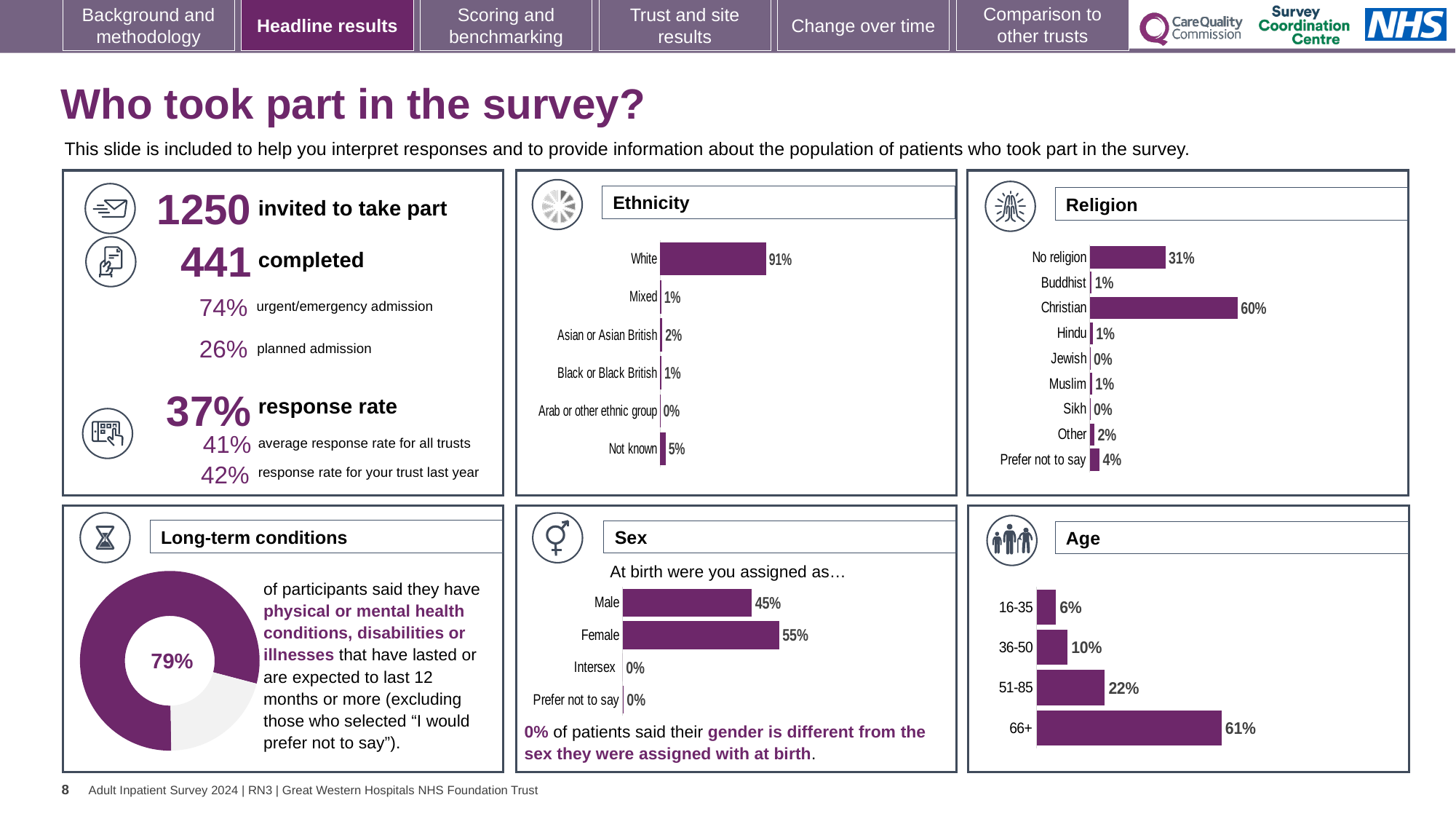
In the Age chart, do the values rise or fall as the age groups get older? rise In the Sex chart, which is larger, Male or Female? Female In the Age chart, which age group has the lowest value? 16-35 In the Age chart, what percentage of participants are aged 66+? 61% In the Religion chart, what is the difference between the Christian and No religion values? 29% What kind of chart is used in the Long-term conditions panel? doughnut chart In the Ethnicity chart, how many categories are shown? 6 In the Ethnicity chart, which category has the highest value? White In the Religion chart, what percentage of participants are Christian? 60% In the Religion chart, how many categories are shown? 9 In the Ethnicity chart, what percentage of participants are White? 91% In the Sex chart, what is the difference between the Female and Male values? 10%